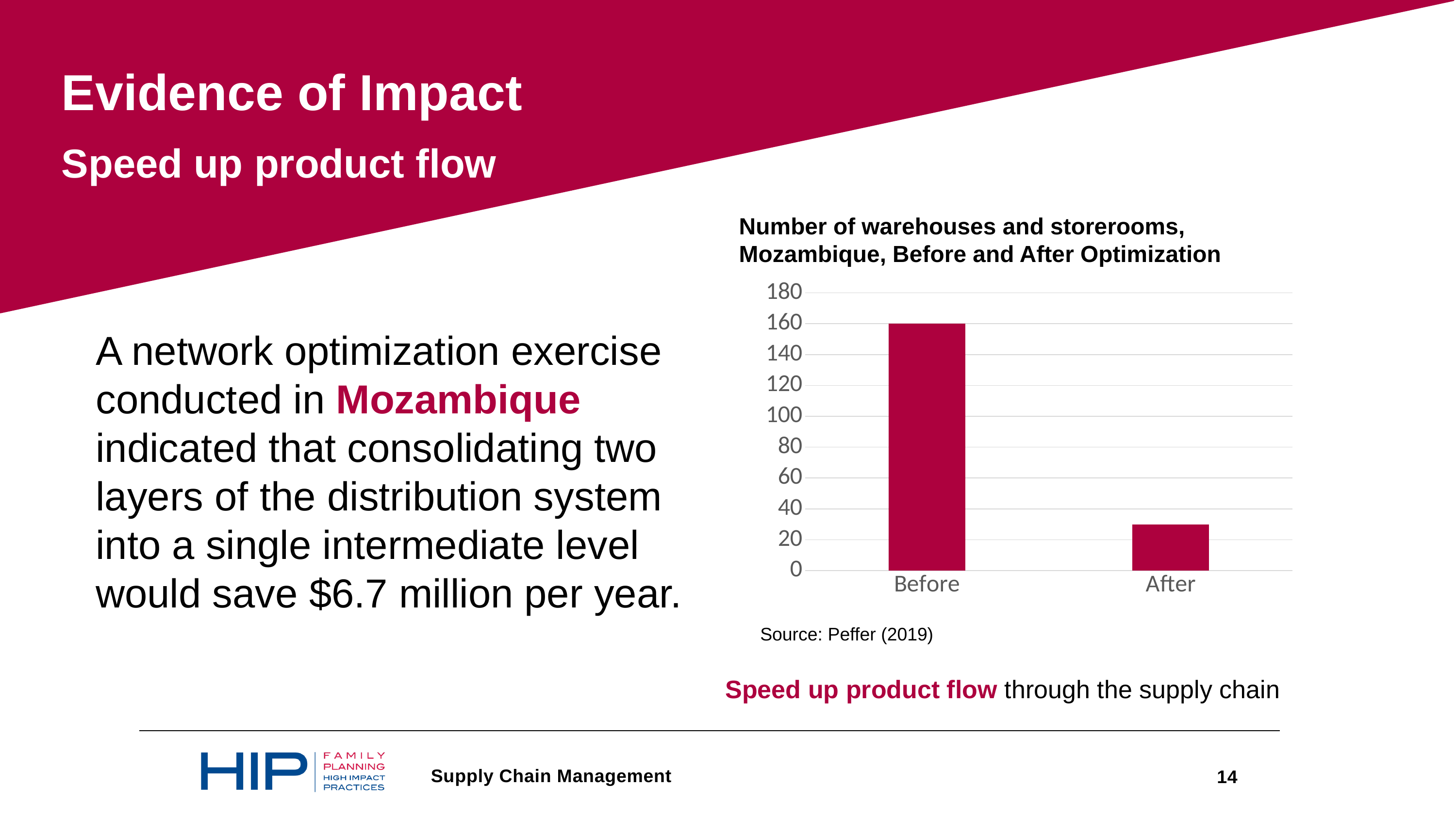
Do the values rise or fall from Before to After? fall What is the highest value shown on the chart's y axis? 180 Is the value for After greater or less than 20? greater How many categories are plotted on the x axis of the chart? 2 What is the number of warehouses and storerooms for Before? 160 Is the value for After greater or less than 40? less Which category has the lowest number of warehouses and storerooms? After Which category has the highest number of warehouses and storerooms? Before Which is larger, the value for Before or the value for After? Before What kind of chart is shown on the slide? bar chart Is the value for Before greater or less than 100? greater What is the title of the chart? Number of warehouses and storerooms, Mozambique, Before and After Optimization